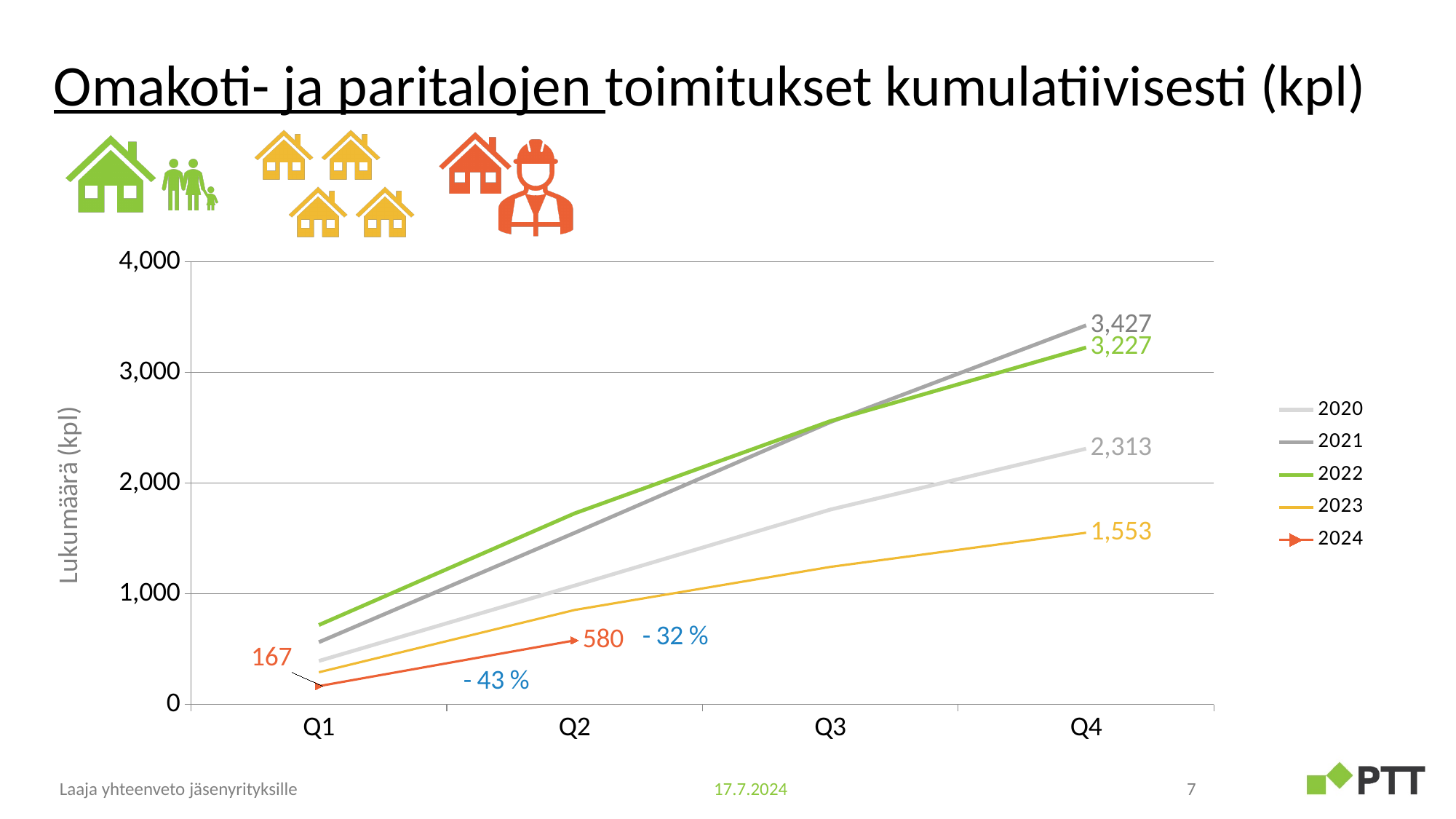
How many series does the legend list? 5 What is the Q4 value for the 2023 series? 1,553 What is the Q4 value for the 2021 series? 3,427 Is the Q4 value for the 2020 series greater or less than 2,000? greater What kind of chart is shown on the slide? line chart How many quarters are shown on the x axis? 4 Which series has the highest value at Q4? 2021 What is the Q4 value for the 2022 series? 3,227 What is the Q1 value for the 2024 series? 167 What is the Q2 value for the 2024 series? 580 What is the difference between the Q4 values of the 2021 and 2022 series? 200 Do the values of the 2023 series rise or fall from Q1 to Q4? rise